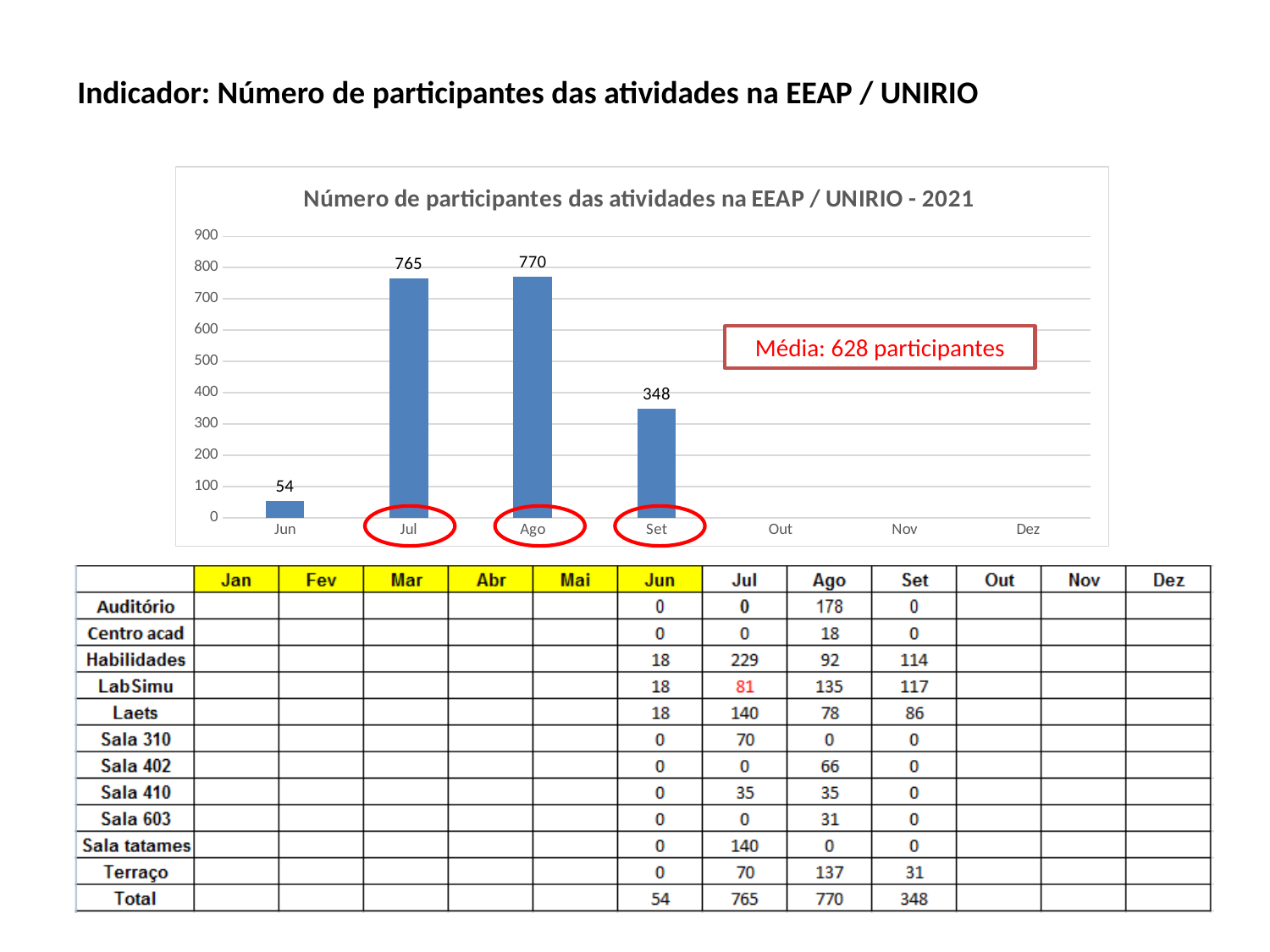
What is the difference between the values for Ago and Jul? 5 How many months are labelled on the x axis of the chart? 7 What average is stated in the red box on the chart? 628 participantes Is the value for Set greater or less than 300? greater What kind of chart is shown on the slide? bar chart Among the months with bars, which has the lowest value? Jun What is the value for Jul in the chart? 765 Which is larger, the value for Set or the value for Jun? Set What is the difference between the values for Jul and Set? 417 What is the value for Set in the chart? 348 What is the value for Jun in the chart? 54 Which month has the highest value in the chart? Ago